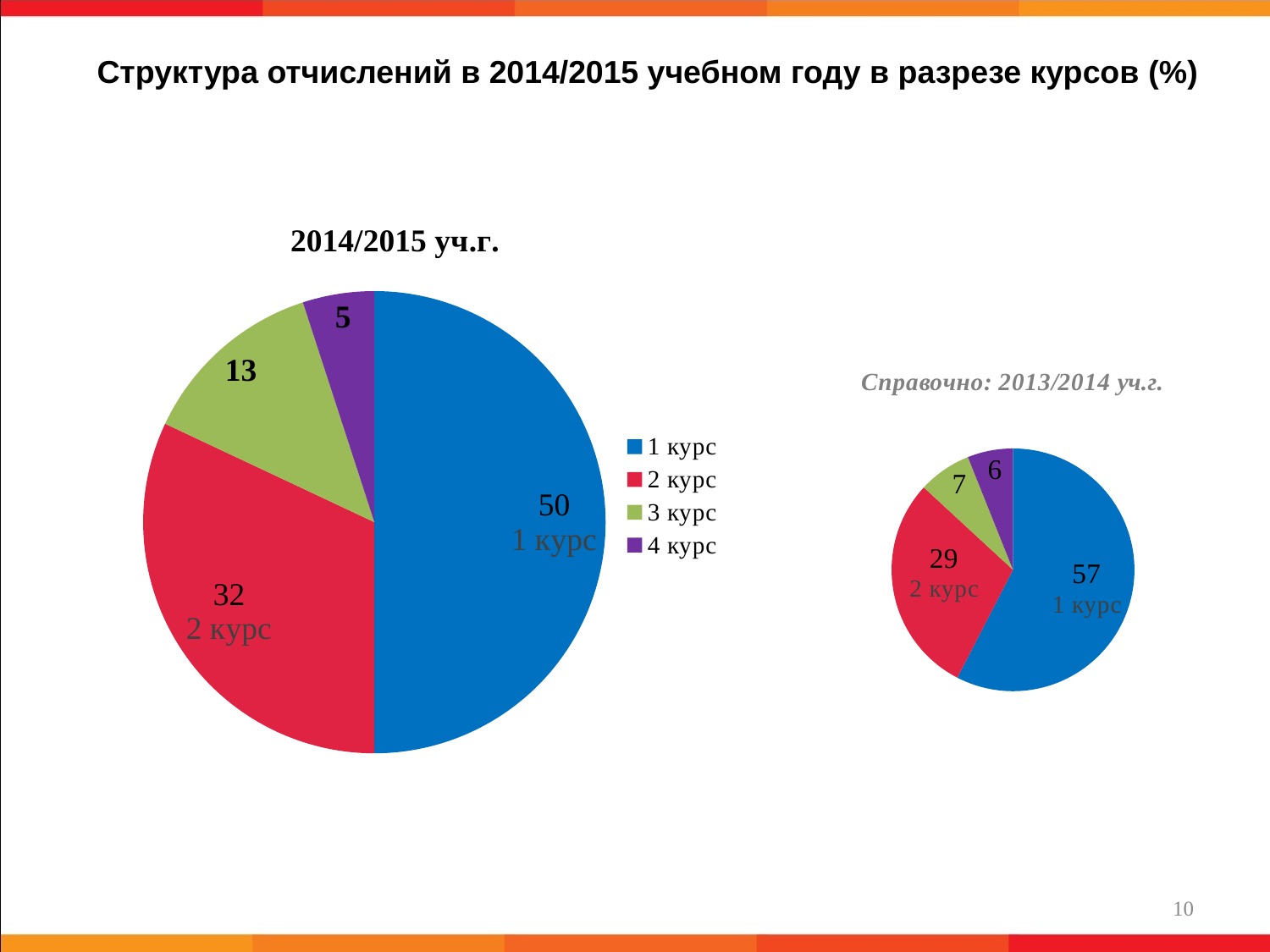
In the 2014/2015 уч.г. pie chart, which course has the largest slice? 1 курс In the 2014/2015 уч.г. pie chart, what is the value for 1 курс? 50 How many entries does the legend list? 4 What type of chart is used for the 2014/2015 уч.г. data? Pie chart In the 2013/2014 уч.г. pie chart, which is larger, the value for 3 курс or 4 курс? 3 курс In the 2014/2015 уч.г. pie chart, which course has the smallest slice? 4 курс In the 2013/2014 уч.г. pie chart, what is the value for 4 курс? 6 In the 2014/2015 уч.г. pie chart, what is the value for 3 курс? 13 In the 2013/2014 уч.г. pie chart, what is the value for 2 курс? 29 Which is larger, the value for 1 курс in the 2014/2015 chart or in the 2013/2014 chart? 2013/2014 In the 2014/2015 уч.г. pie chart, what is the difference between the values for 1 курс and 2 курс? 18 How many slices does the 2014/2015 уч.г. pie chart have? 4